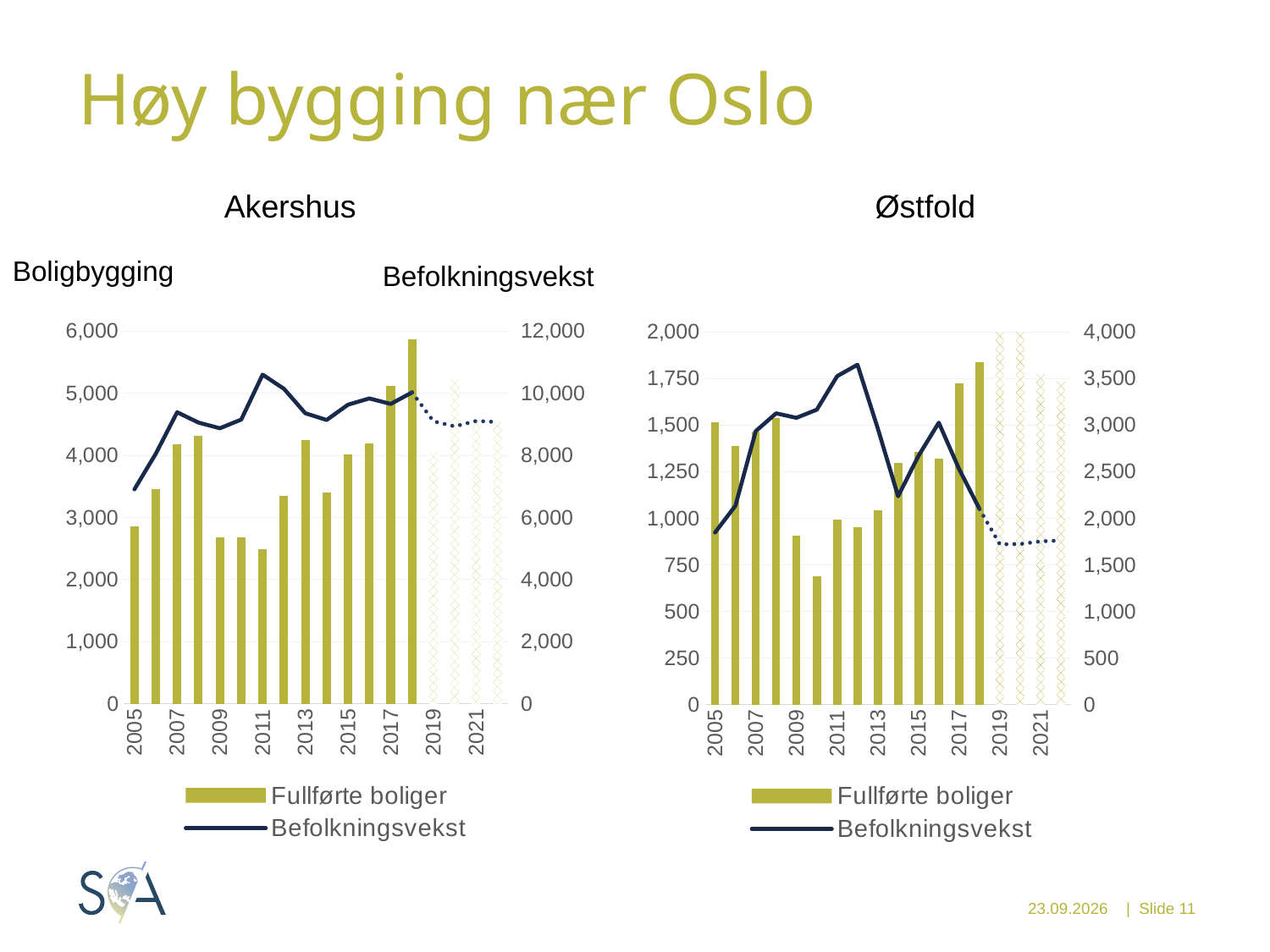
In the Akershus chart, is the Fullførte boliger bar for 2018 greater or less than 5,000? greater In the Østfold chart, does the Befolkningsvekst line rise or fall from 2012 to 2019? fall In the Østfold chart, which year has the tallest solid bar for Fullførte boliger? 2018 In the Akershus chart, which year has the tallest solid bar for Fullførte boliger? 2018 In the Østfold chart, which bar is taller: Fullførte boliger in 2005 or in 2010? 2005 In the Østfold chart, is the Fullførte boliger bar for 2010 greater or less than 750? less In the Akershus chart, is the Fullførte boliger bar for 2011 greater or less than 3,000? less How many series does the legend of the Akershus chart list? 2 In the Østfold chart, which year has the lowest bar for Fullførte boliger? 2010 In the Akershus chart, which bar is taller: Fullførte boliger in 2007 or in 2009? 2007 What kind of chart is the Østfold chart? Combined bar and line chart